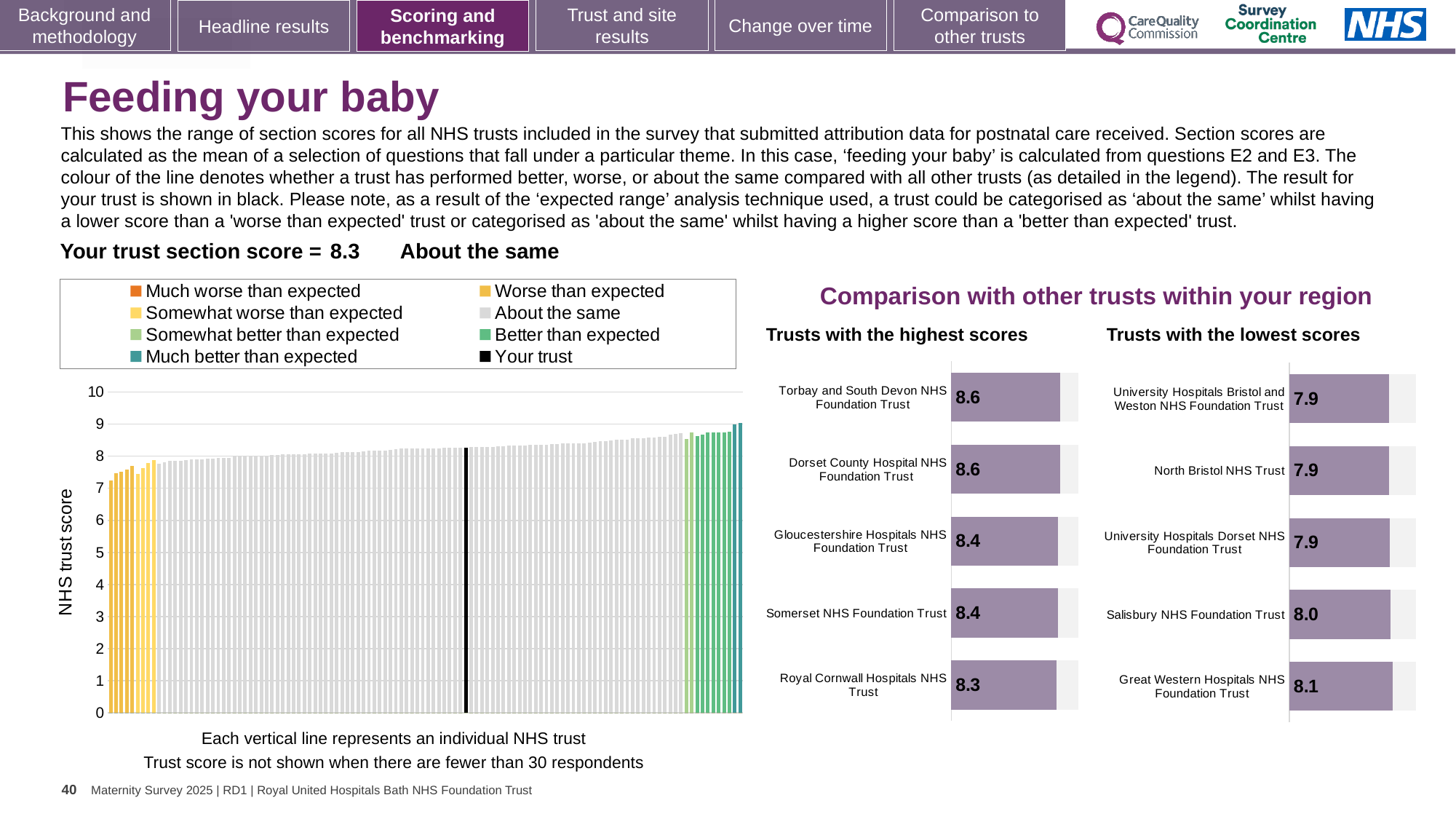
In the 'Trusts with the lowest scores' chart, what is the score for Salisbury NHS Foundation Trust? 8.0 In the 'Trusts with the highest scores' chart, what is the score for Royal Cornwall Hospitals NHS Trust? 8.3 In the 'Trusts with the highest scores' chart, what is the difference between the scores of Torbay and South Devon NHS Foundation Trust and Royal Cornwall Hospitals NHS Trust? 0.3 In the 'Trusts with the highest scores' chart, what is the score for Torbay and South Devon NHS Foundation Trust? 8.6 In the 'Trusts with the highest scores' chart, which has the larger score: Gloucestershire Hospitals NHS Foundation Trust or Royal Cornwall Hospitals NHS Trust? Gloucestershire Hospitals NHS Foundation Trust In the 'Trusts with the lowest scores' chart, which trust has the highest score shown? Great Western Hospitals NHS Foundation Trust In the 'Trusts with the lowest scores' chart, what is the score for Great Western Hospitals NHS Foundation Trust? 8.1 How many trusts are listed in the 'Trusts with the lowest scores' chart? 5 What kind of chart is the main chart on the left showing all NHS trusts? Bar chart How many entries does the legend of the main chart on the left list? 8 In the main chart on the left, is the value of the lowest bar greater or less than 8? less What is the label on the vertical axis of the main chart on the left? NHS trust score